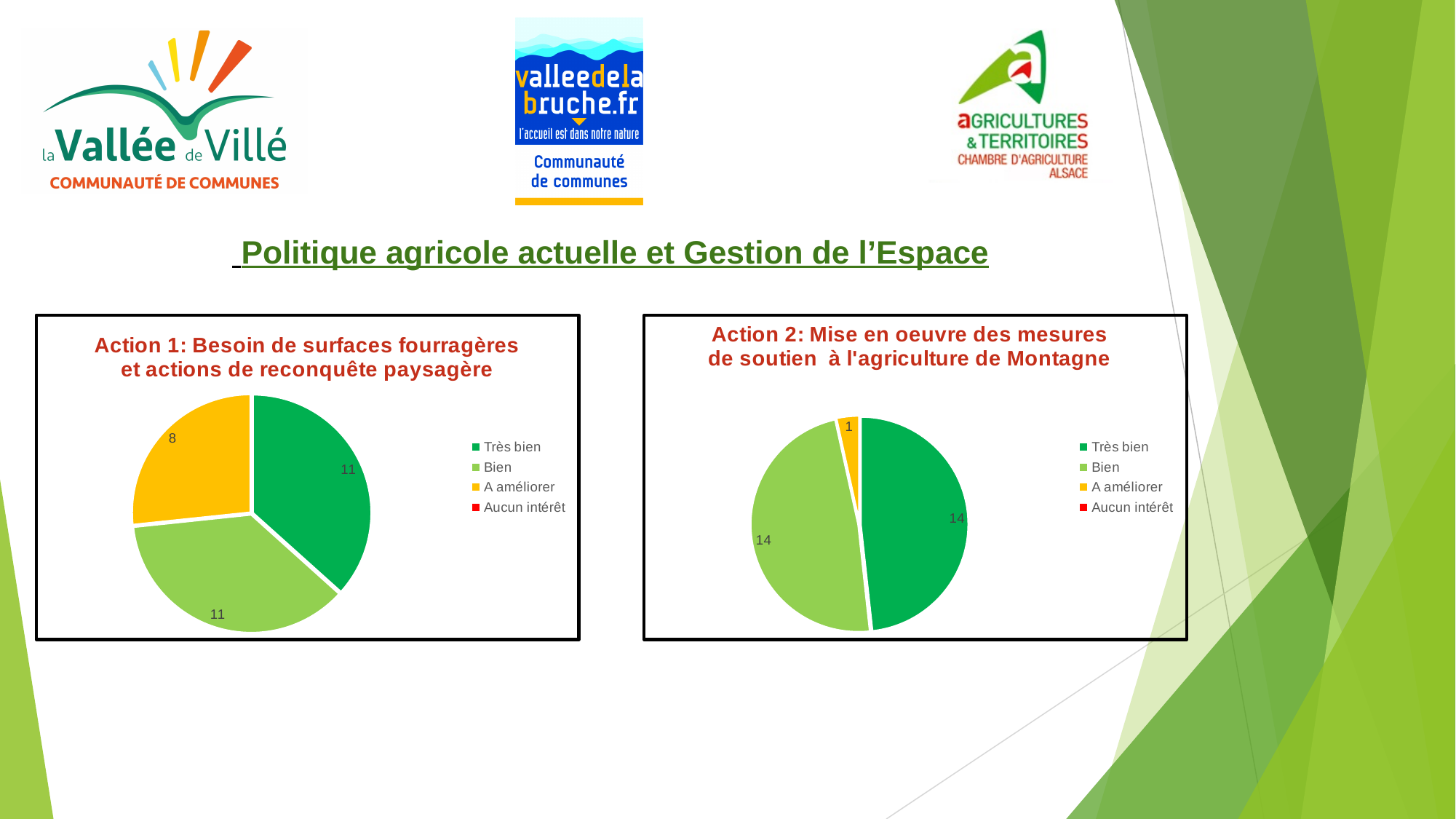
In the Action 1 chart, which labelled category has the smallest slice? A améliorer In the Action 2 chart, what is the difference between the 'Très bien' value and the 'A améliorer' value? 13 In the Action 2 chart, which labelled category has the smallest slice? A améliorer What type of chart is used for Action 2? Pie chart In the Action 1 chart, what is the difference between the 'Très bien' value and the 'A améliorer' value? 3 How many entries does the legend of the Action 1 chart list? 4 In the Action 1 chart, which is larger: 'Bien' or 'A améliorer'? Bien In the Action 2 chart, which colour represents 'A améliorer'? Yellow In the Action 1 chart, what value is shown for the 'Très bien' slice? 11 In the Action 2 chart, what value is shown for the 'Bien' slice? 14 In the Action 2 chart, what value is shown for the 'A améliorer' slice? 1 In the Action 1 chart, what value is shown for the 'A améliorer' slice? 8